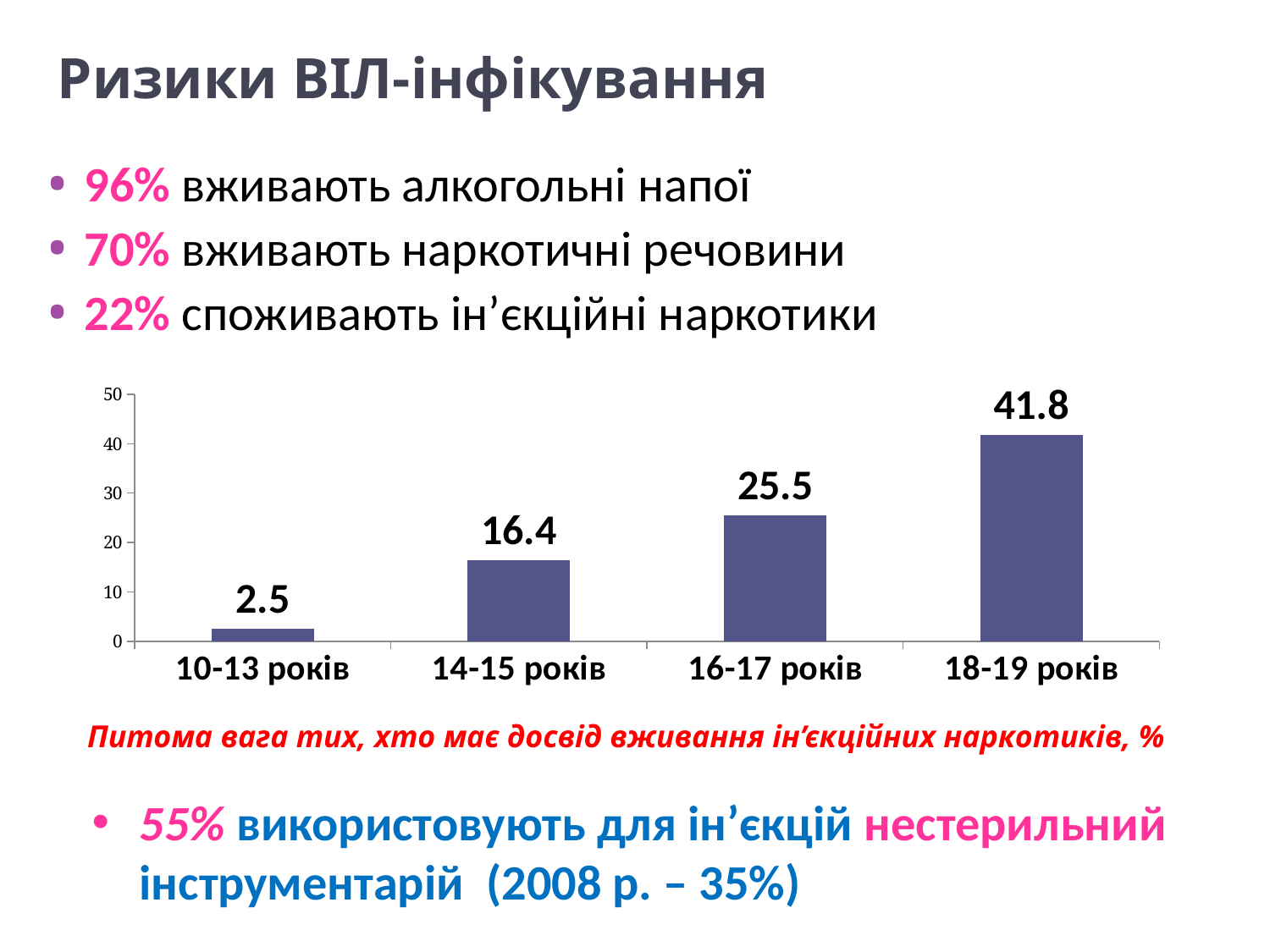
Is the value for 18-19 років greater or less than 40? greater What is the value for the 14-15 років age group? 16.4 What is the difference between the values for 18-19 років and 16-17 років? 16.3 What is the value for the 18-19 років age group? 41.8 Do the values rise or fall as the age groups increase along the x axis? rise What is the difference between the values for 16-17 років and 14-15 років? 9.1 What kind of chart is shown on the slide? bar chart Which age group has the highest value? 18-19 років Which is larger, the value for 16-17 років or the value for 14-15 років? 16-17 років What is the value for the 10-13 років age group? 2.5 How many age groups are shown on the chart? 4 Which age group has the lowest value? 10-13 років